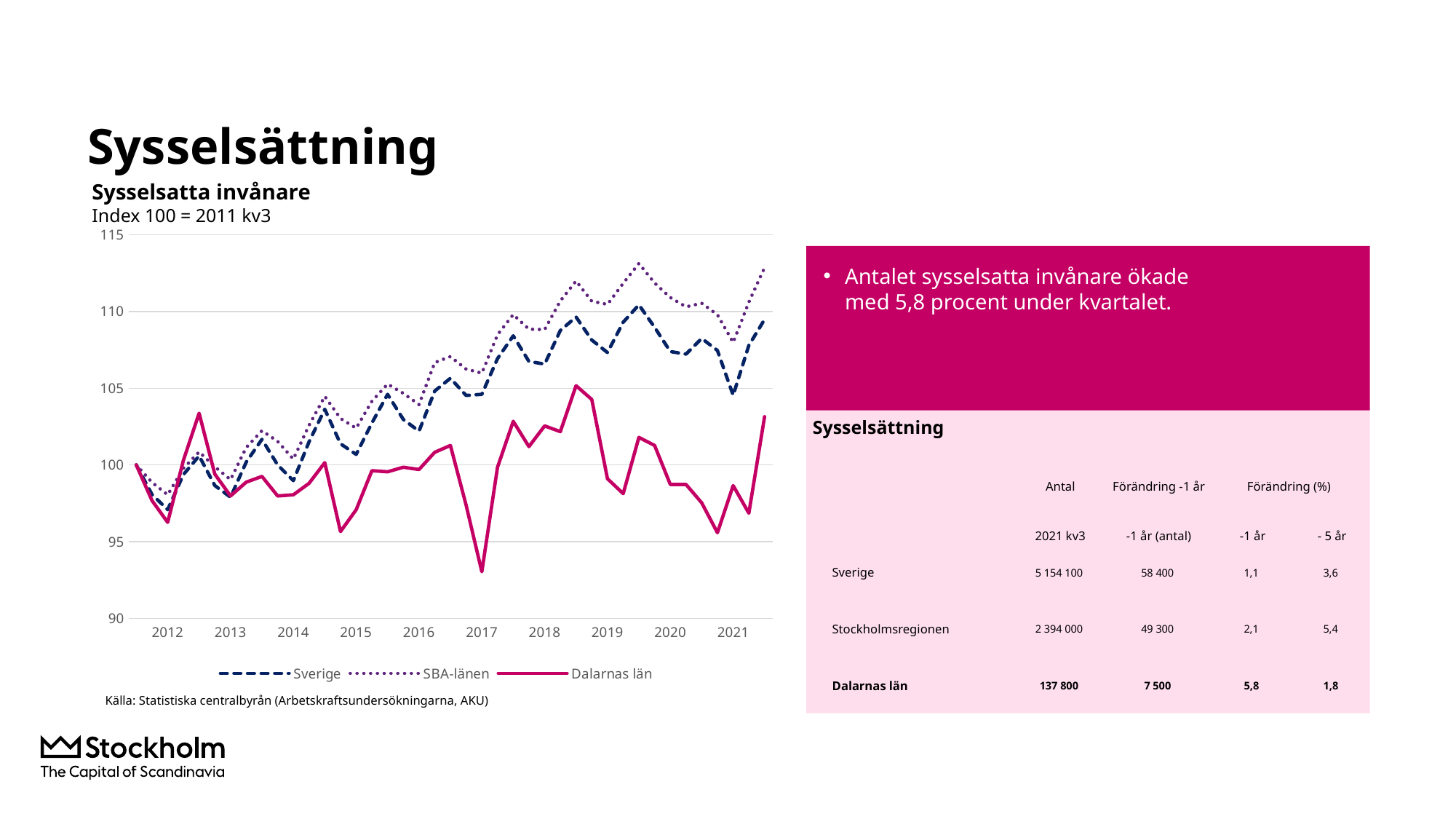
How many year labels are shown on the x axis of the chart? 10 What kind of chart is shown on the slide? line chart Is the value of the Dalarnas län line at the end of 2021 greater or less than 100? greater Is the value of the Sverige line at the end of 2021 greater or less than 105? greater Which series has the highest value at the end of the chart in 2021? SBA-länen Does the SBA-länen line overall rise or fall from 2012 to 2021? rise Is the lowest value of the Dalarnas län line, around 2017, greater or less than 95? less How many series does the chart legend list? 3 What is the title of the chart? Sysselsatta invånare Which series has the lowest value around 2017? Dalarnas län Which series are listed in the chart legend? Sverige, SBA-länen, Dalarnas län